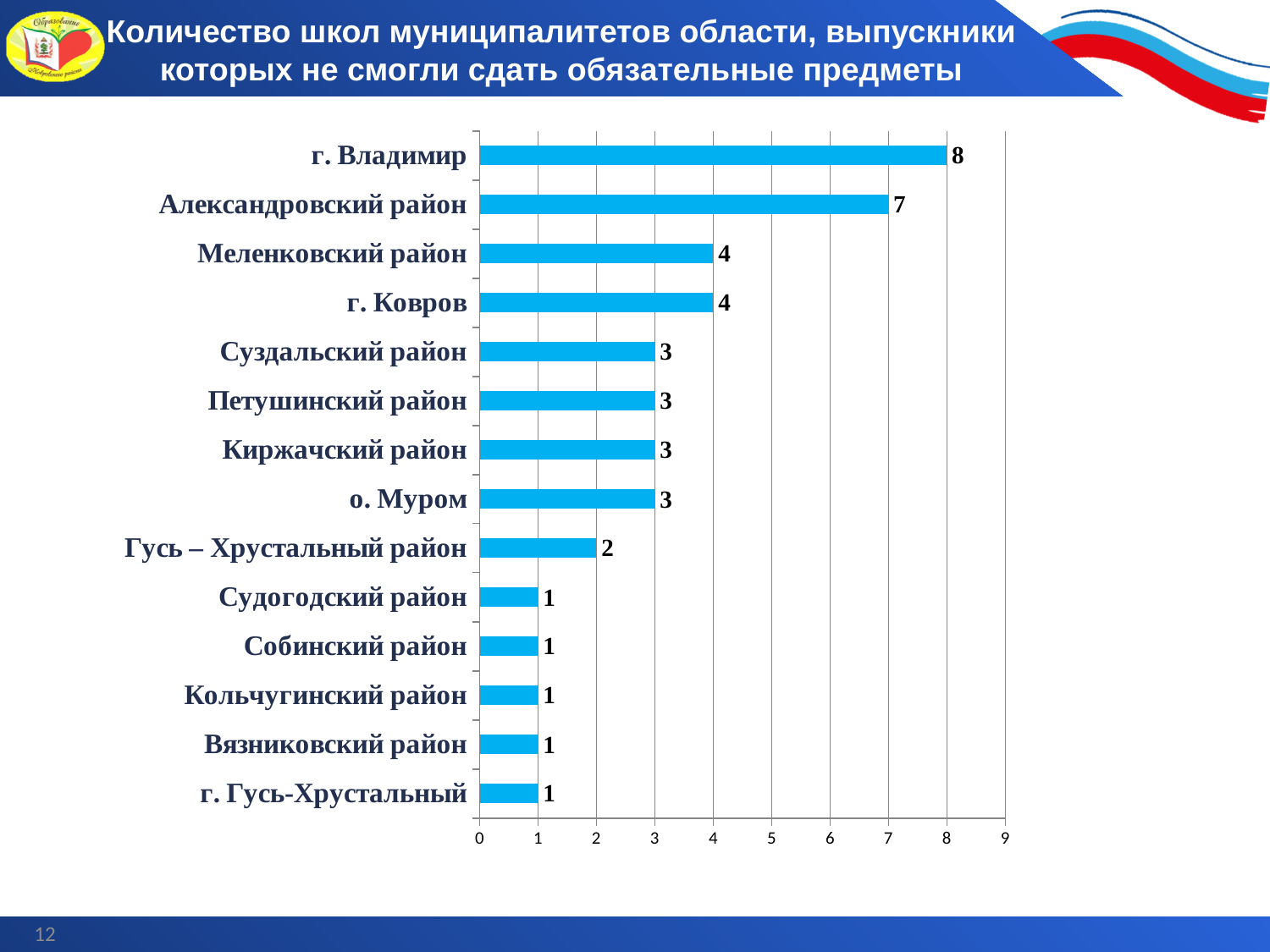
Which category has the highest value? г. Владимир What is the difference between the values for г. Ковров and Судогодский район? 3 Which is larger, the value for Меленковский район or the value for Суздальский район? Меленковский район What kind of chart is shown on the slide? Bar chart What is the highest tick value on the horizontal axis? 9 What is the value for Гусь – Хрустальный район? 2 What is the lowest value shown on the chart? 1 What is the value for о. Муром? 3 How many categories are shown on the chart? 14 What is the difference between the values for г. Владимир and Александровский район? 1 What is the value for г. Владимир? 8 What is the value for Александровский район? 7